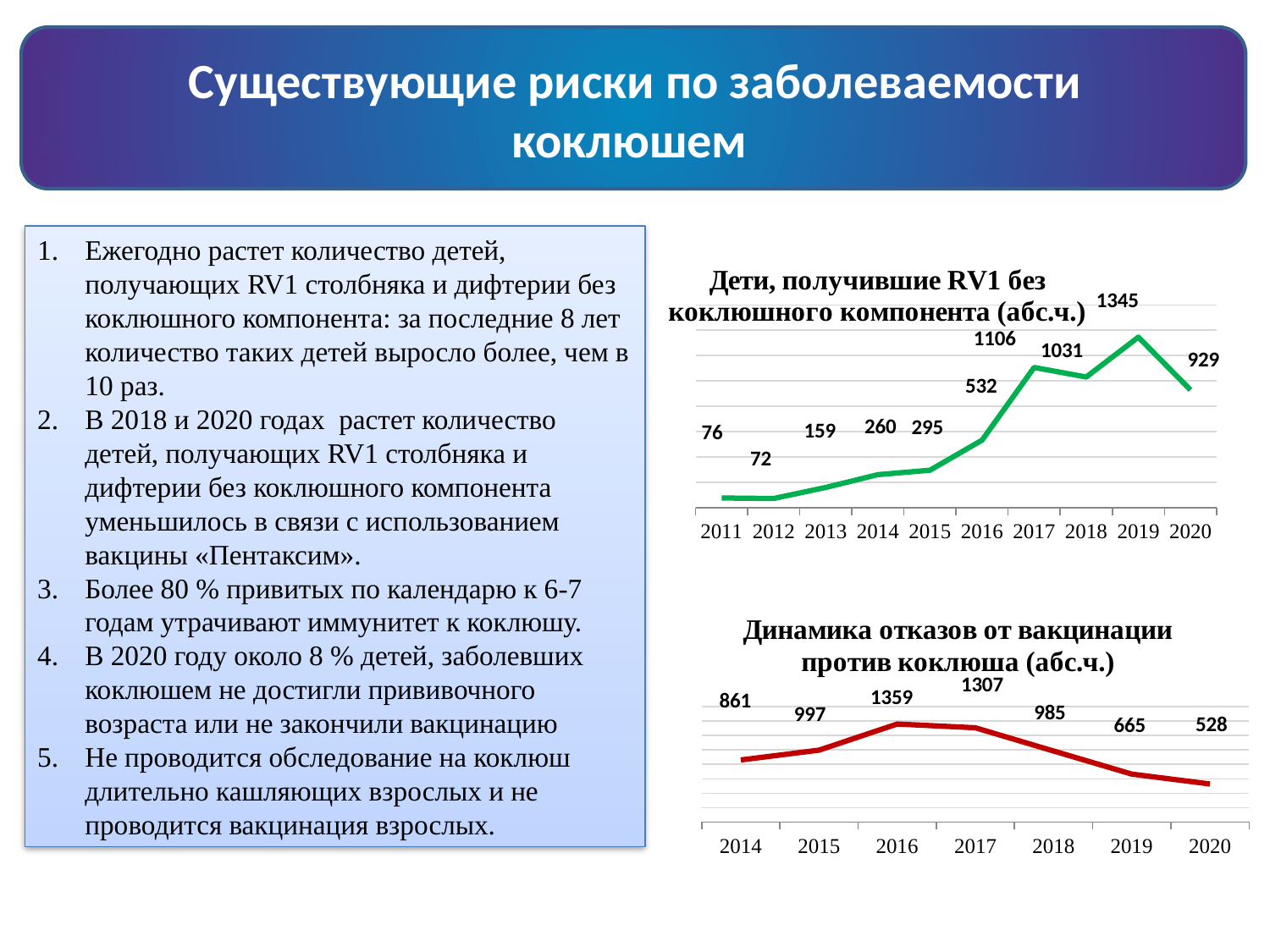
In the chart 'Динамика отказов от вакцинации против коклюша (абс.ч.)', which year has the lowest value? 2020 In the chart 'Дети, получившие RV1 без коклюшного компонента (абс.ч.)', which year has the lowest value? 2012 In the chart 'Динамика отказов от вакцинации против коклюша (абс.ч.)', what is the value for 2016? 1359 In the chart 'Дети, получившие RV1 без коклюшного компонента (абс.ч.)', what is the value for 2019? 1345 In the chart 'Динамика отказов от вакцинации против коклюша (абс.ч.)', which is larger, the value for 2014 or the value for 2018? 2018 In the chart 'Дети, получившие RV1 без коклюшного компонента (абс.ч.)', which year has the highest value? 2019 In the chart 'Динамика отказов от вакцинации против коклюша (абс.ч.)', what is the difference between the values for 2016 and 2020? 831 What type of chart is 'Динамика отказов от вакцинации против коклюша (абс.ч.)'? Line chart In the chart 'Дети, получившие RV1 без коклюшного компонента (абс.ч.)', how many years are plotted? 10 In the chart 'Дети, получившие RV1 без коклюшного компонента (абс.ч.)', what is the difference between the values for 2019 and 2020? 416 In the chart 'Динамика отказов от вакцинации против коклюша (абс.ч.)', do the values rise or fall from 2017 to 2020? Fall In the chart 'Дети, получившие RV1 без коклюшного компонента (абс.ч.)', what is the value for 2016? 532